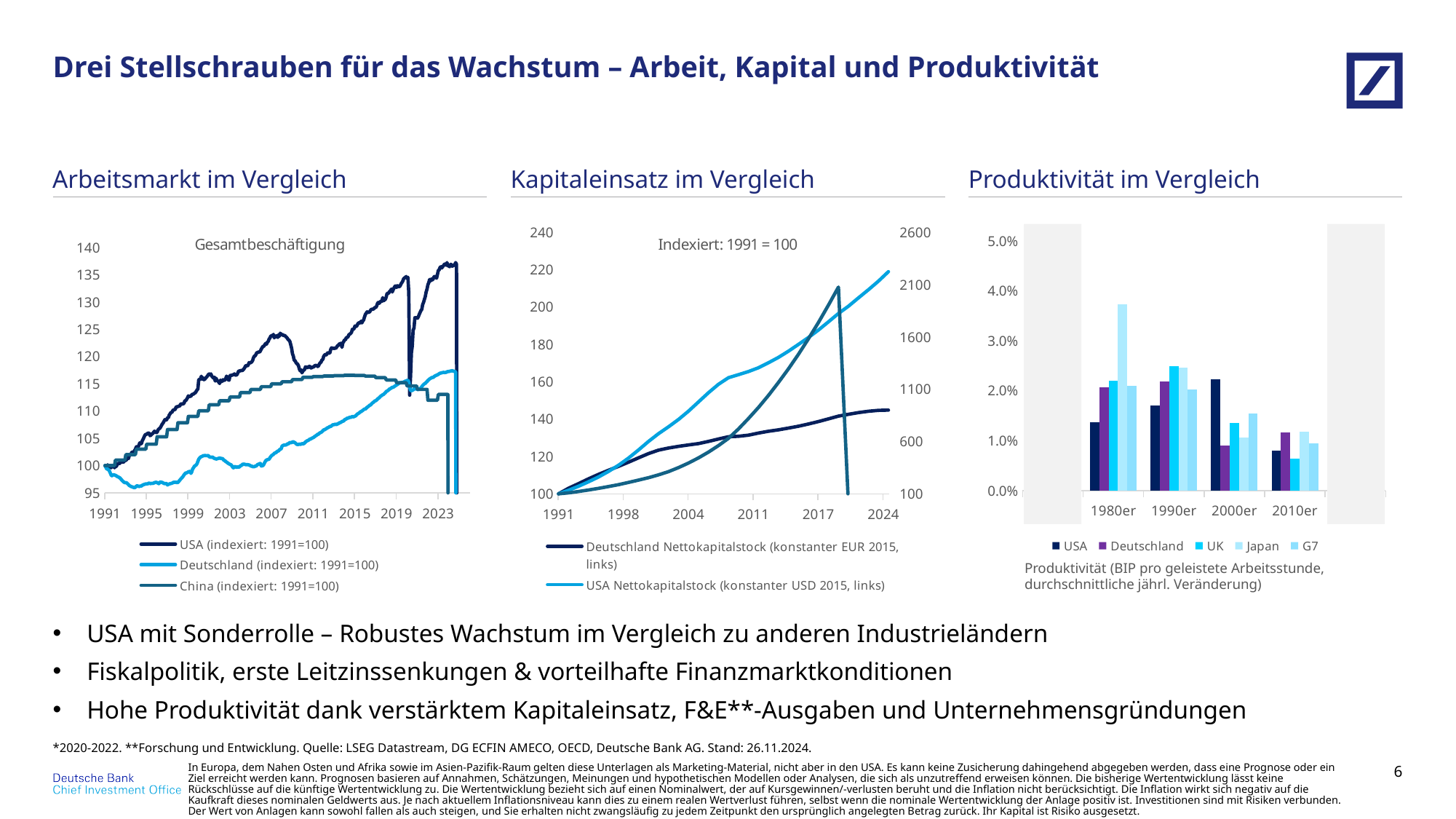
How many series does the legend of the "Arbeitsmarkt im Vergleich" chart list? 3 In the "Arbeitsmarkt im Vergleich" chart, is the peak value of the China line greater or less than 120? less What subtitle is printed inside the "Arbeitsmarkt im Vergleich" chart? Gesamtbeschäftigung In the "Produktivität im Vergleich" chart, which is larger in the 2000er category: USA or Deutschland? USA In the "Kapitaleinsatz im Vergleich" chart, is the value for Deutschland Nettokapitalstock in 2024 greater or less than 160 on the left axis? less What kind of chart is the "Produktivität im Vergleich" chart? Bar chart In the "Produktivität im Vergleich" chart, which series has the highest bar in the 1980er category? Japan In the "Arbeitsmarkt im Vergleich" chart, is the value for USA in 2023 greater or less than 130? greater What kind of chart is the "Arbeitsmarkt im Vergleich" chart? Line chart How many decade categories are shown on the x axis of the "Produktivität im Vergleich" chart? 4 How many series does the legend of the "Produktivität im Vergleich" chart list? 5